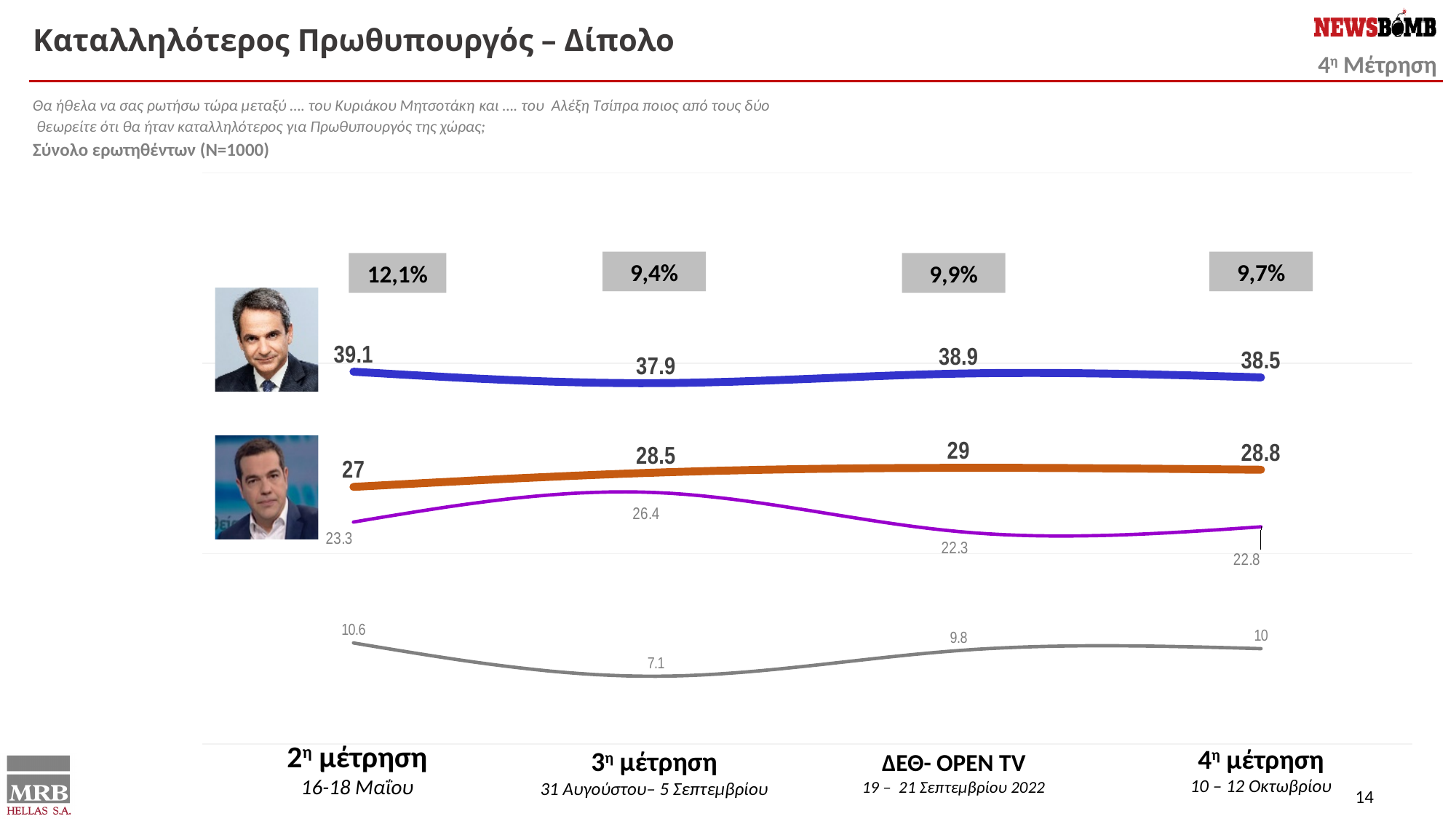
What kind of chart is shown on the slide? line chart What is the difference between the blue line (Mitsotakis) and the orange line (Tsipras) at the 3η μέτρηση point? 9.4 How many measurement points are plotted along the x axis? 4 At which measurement point is the blue line (Mitsotakis) lowest? 3η μέτρηση What is the value of the grey line at the 3η μέτρηση point? 7.1 What percentage is shown in the grey box above the 2η μέτρηση point? 12,1% What is the value of the blue line (Mitsotakis) at the 4η μέτρηση point? 38.5 What is the value of the orange line (Tsipras) at the ΔΕΘ- OPEN TV point? 29 What is the value of the blue line (Mitsotakis) at the 2η μέτρηση point? 39.1 What is the value of the purple line at the 4η μέτρηση point? 22.8 Which is larger at the 2η μέτρηση point: the orange line (Tsipras) or the purple line? the orange line (Tsipras) At which measurement point is the orange line (Tsipras) highest? ΔΕΘ- OPEN TV